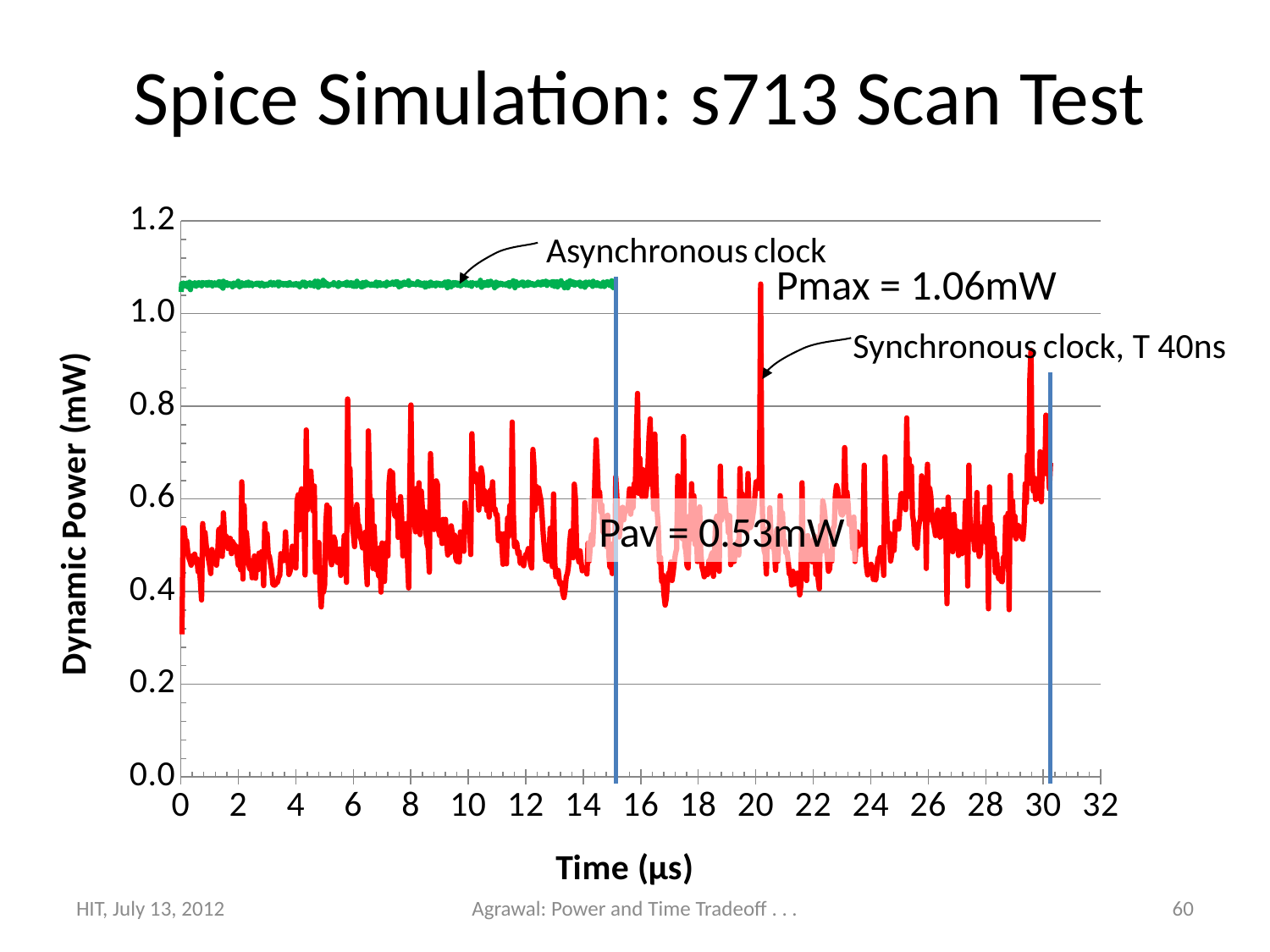
How many data series are plotted on the chart? 2 Which series shows the higher dynamic power, the Asynchronous clock or the Synchronous clock? Asynchronous clock What colour is the Asynchronous clock line? Green What is the title of the slide's chart? Spice Simulation: s713 Scan Test What is the value of Pav annotated on the chart? 0.53mW Is the dynamic power of the Synchronous clock at 2 µs greater or less than 0.8 mW? less What is the highest value shown on the Time (µs) axis? 32 What is the highest value shown on the Dynamic Power (mW) axis? 1.2 What kind of chart is shown on the slide? Line chart What is the value of Pmax annotated on the chart? 1.06mW Is the dynamic power of the Asynchronous clock greater or less than 1.0 mW? greater Does the Asynchronous clock line rise, fall, or stay flat over time? Stays flat